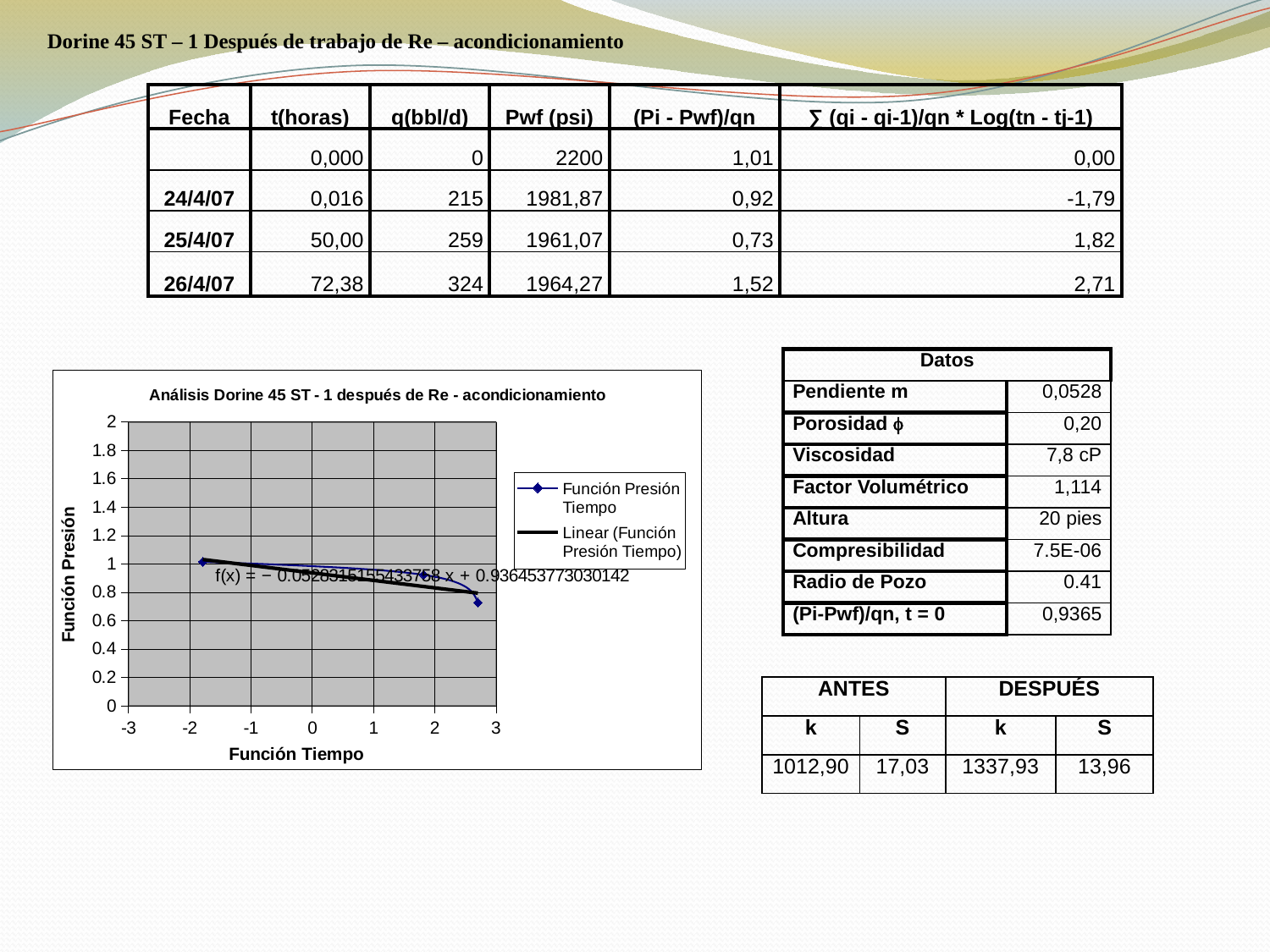
What kind of chart is shown on the slide? Line chart with markers (scatter with linear trendline) According to the trendline, do the values of Función Presión rise or fall as Función Tiempo increases? Fall What is the highest value shown on the y axis (Función Presión) of the chart? 2 What is the label of the x axis of the chart? Función Tiempo Is the Función Presión value of the leftmost data point (near Función Tiempo = -2) greater or less than 0.8? greater Is the Función Presión value of the lowest data point (near Función Tiempo = 3) greater or less than 1? less How many entries does the chart legend list? 2 Is the slope of the linear trendline in the chart positive or negative? Negative What is the title of the chart? Análisis Dorine 45 ST - 1 después de Re - acondicionamiento